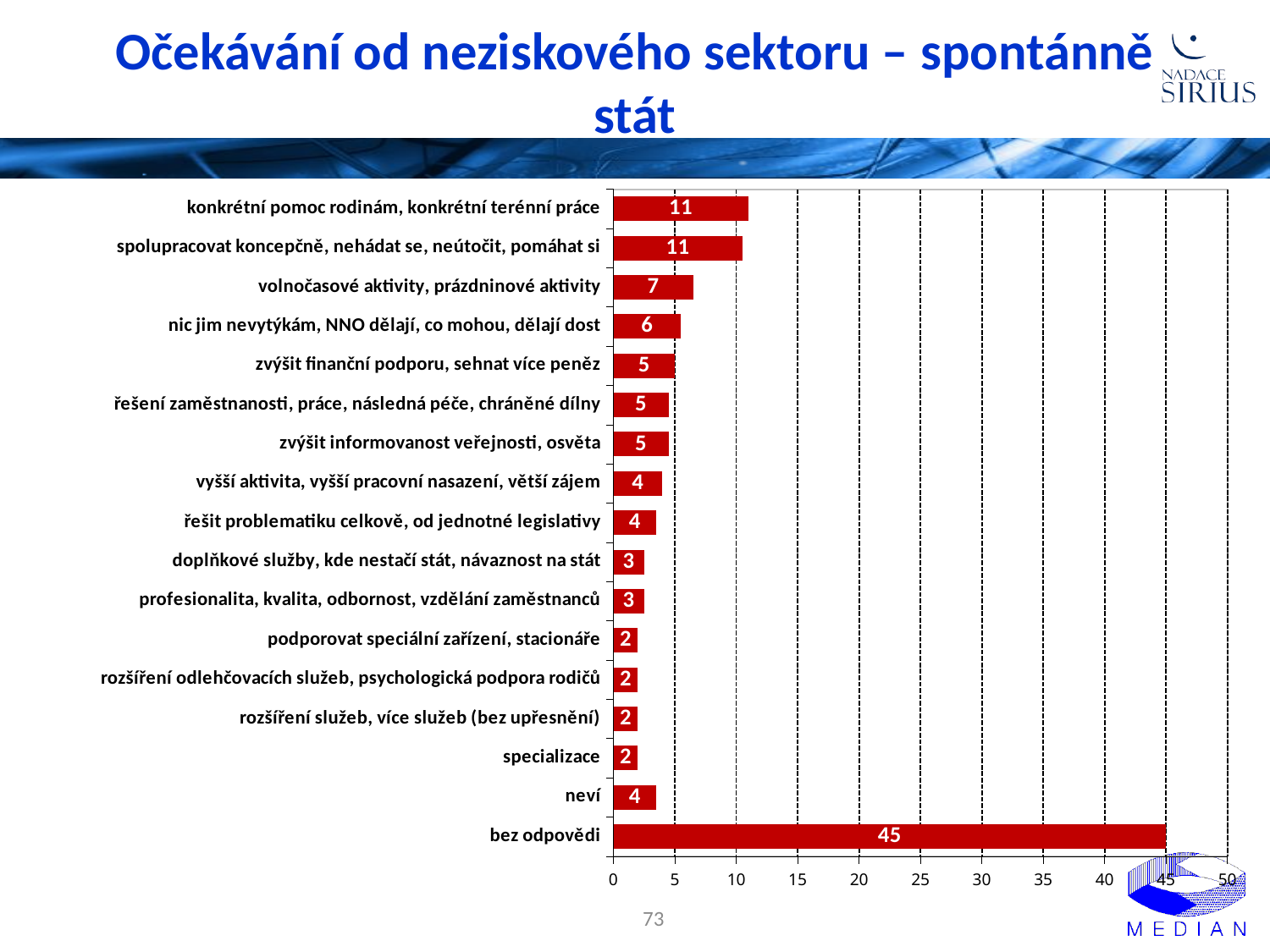
What is the value for "nic jim nevytýkám, NNO dělají, co mohou, dělají dost"? 6 What is the value for "neví"? 4 Is the value for "bez odpovědi" greater or less than 40? greater How many categories are shown in the chart? 17 What is the value for "volnočasové aktivity, prázdninové aktivity"? 7 What is the difference between the values for "bez odpovědi" and "konkrétní pomoc rodinám, konkrétní terénní práce"? 34 Which is larger: the value for "volnočasové aktivity, prázdninové aktivity" or the value for "profesionalita, kvalita, odbornost, vzdělání zaměstnanců"? volnočasové aktivity, prázdninové aktivity What kind of chart is shown on the slide? bar chart What is the value for "bez odpovědi"? 45 What is the difference between the values for "volnočasové aktivity, prázdninové aktivity" and "zvýšit finanční podporu, sehnat více peněz"? 2 Which category has the highest value? bez odpovědi What is the value for "specializace"? 2